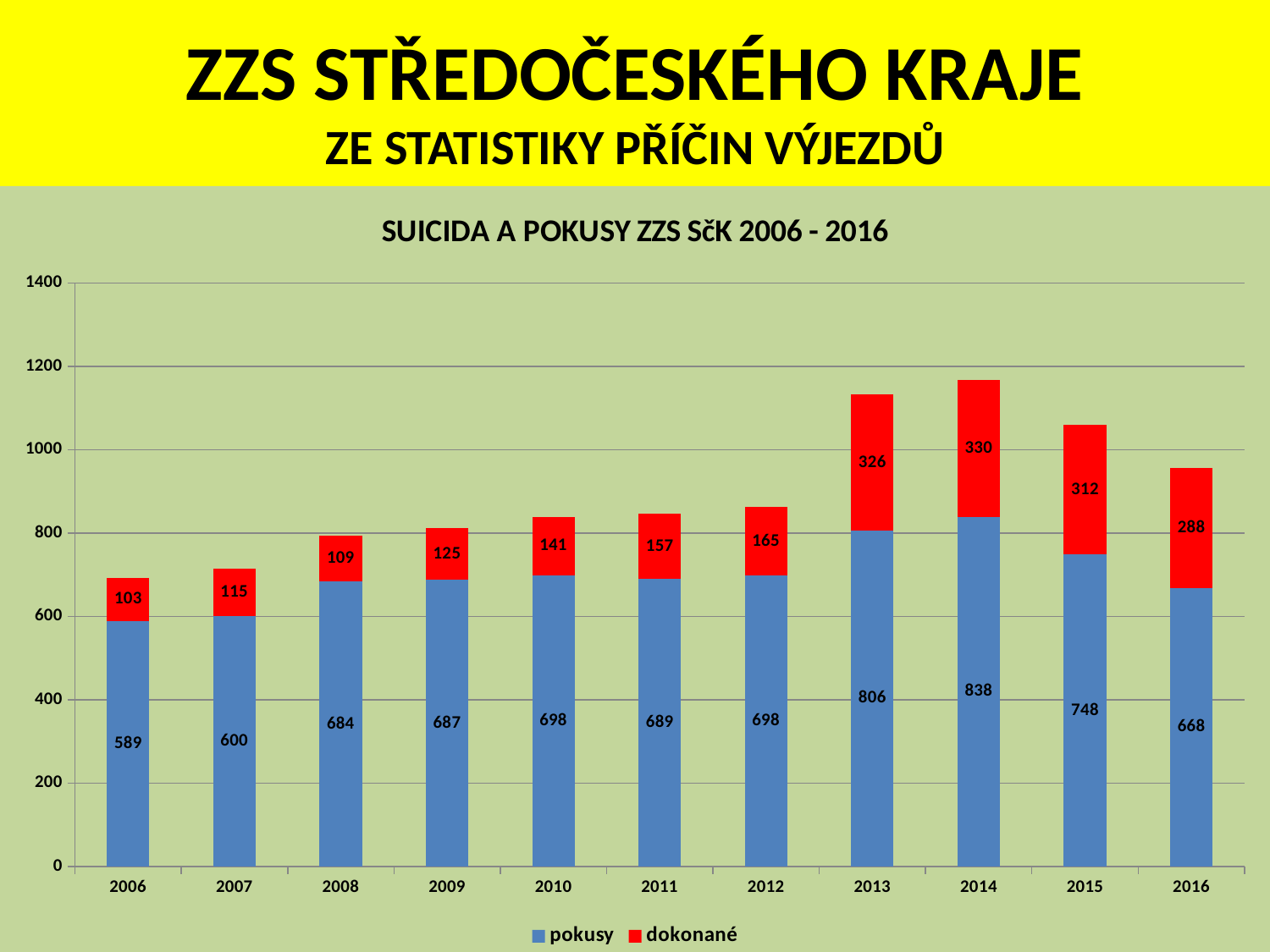
Which year has the lowest value for pokusy? 2006 What is the value of dokonané for 2016? 288 Which is larger, the dokonané value for 2015 or for 2016? 2015 What is the value of pokusy for 2014? 838 What kind of chart is shown on the slide? stacked bar chart How many series does the legend list? 2 What is the total of the stacked bar for 2014? 1168 How many years are shown on the x axis? 11 Is the total height of the stacked bar for 2013 greater or less than 1000? greater Which year has the highest value for pokusy? 2014 What is the difference between the pokusy values for 2014 and 2006? 249 Do the dokonané values rise or fall from 2006 to 2014? rise